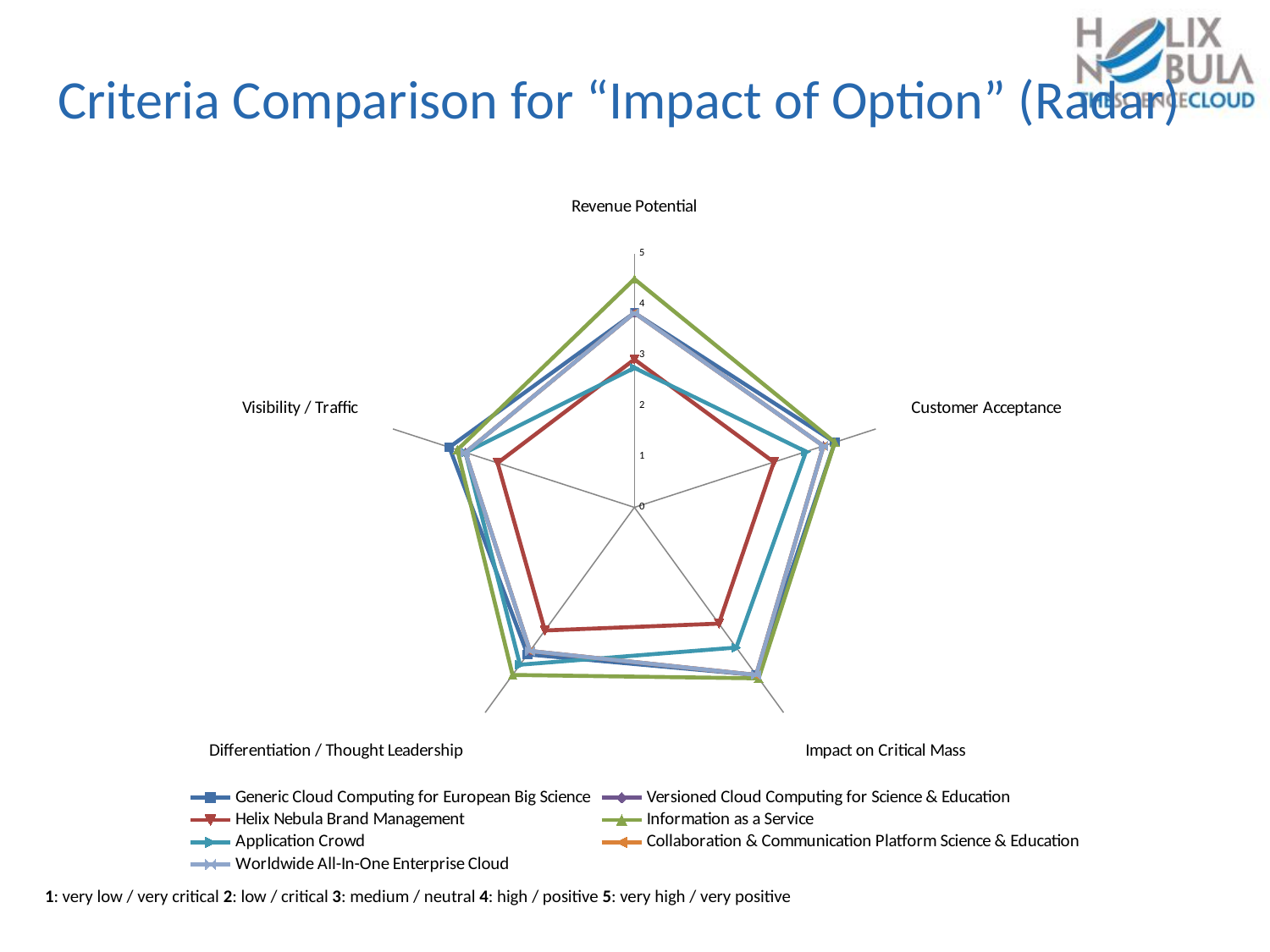
On the Revenue Potential axis, which is larger: Information as a Service or Helix Nebula Brand Management? Information as a Service Which series has the highest value on the Revenue Potential axis? Information as a Service What is the title of the chart on the slide? Criteria Comparison for "Impact of Option" (Radar) How many criteria (axes) does the radar chart have? 5 How many series does the legend list? 7 Is the value for Helix Nebula Brand Management on the Customer Acceptance axis greater or less than 4? less What is the maximum value shown on the radar chart's scale? 5 Which series has the lowest value on the Customer Acceptance axis? Helix Nebula Brand Management What kind of chart is shown on the slide? Radar chart Is the value for Information as a Service on the Customer Acceptance axis greater or less than 3? greater